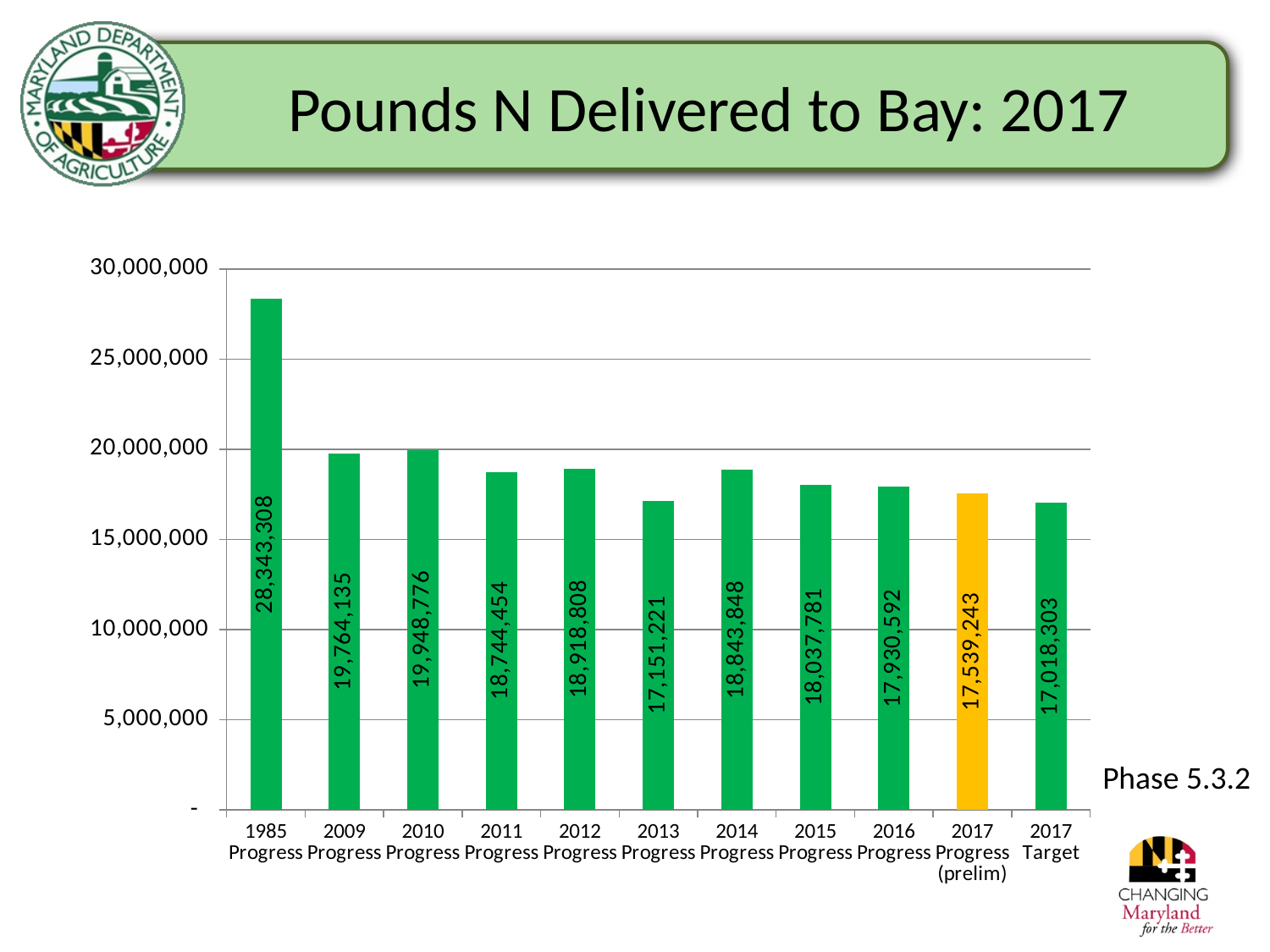
From 2014 Progress to 2017 Progress (prelim), do the values rise or fall? fall Which category has the highest value? 1985 Progress Is the value for 1985 Progress greater or less than 25,000,000? greater What is the difference between the 2017 Progress (prelim) value and the 2017 Target value? 520,940 What is the value for 2017 Target? 17,018,303 What is the value for 2017 Progress (prelim)? 17,539,243 What is the difference between the 1985 Progress value and the 2017 Progress (prelim) value? 10,804,065 What is the value for 1985 Progress? 28,343,308 Which is larger, the value for 2013 Progress or the value for 2015 Progress? 2015 Progress What kind of chart is shown on the slide? bar chart Which category has the lowest value? 2017 Target How many bars are shown in the chart? 11